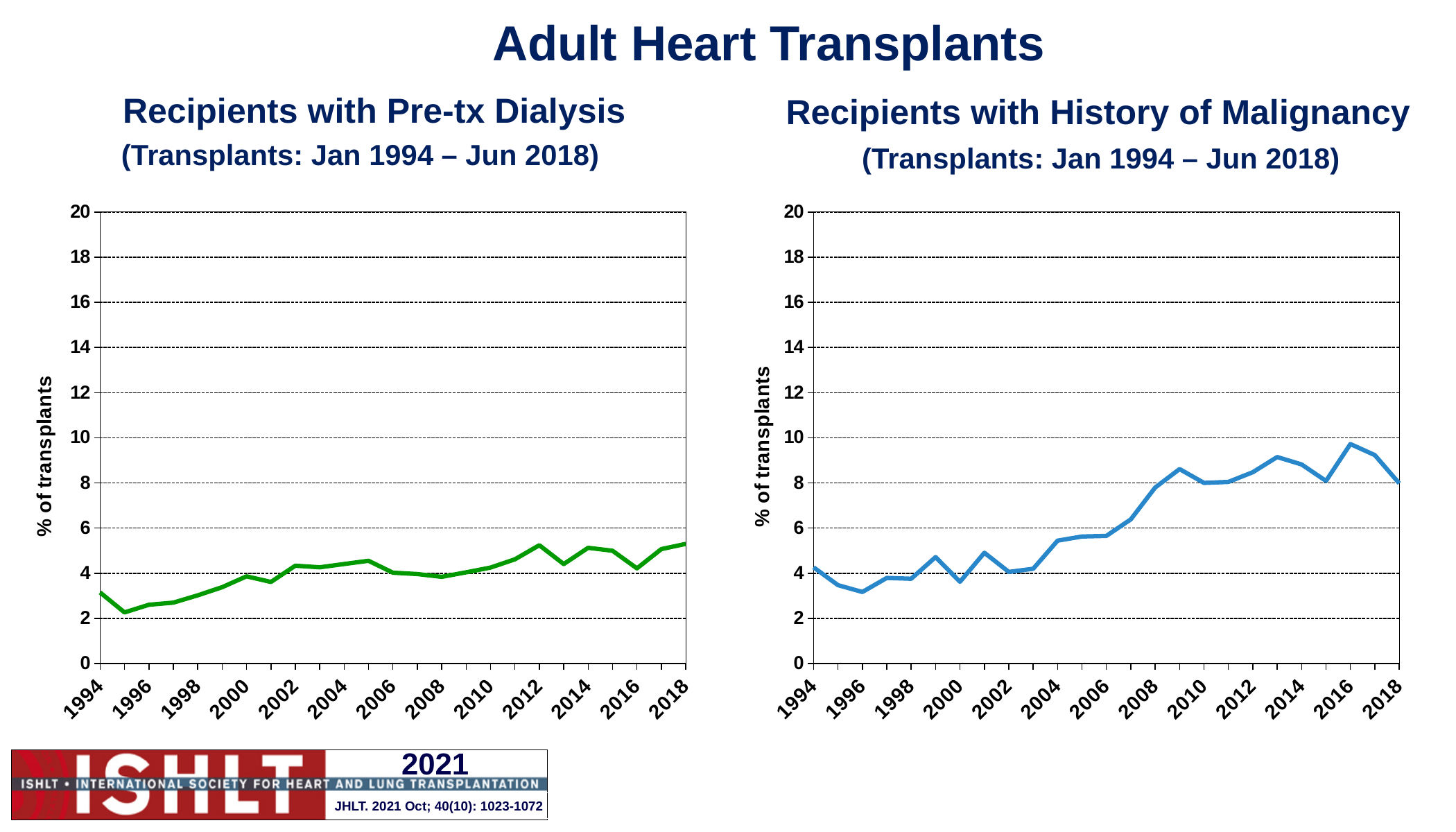
In the 'Recipients with History of Malignancy' chart, is the value for 2010 larger or smaller than the value for 2000? larger In the 'Recipients with Pre-tx Dialysis' chart, is the value for 2012 greater or less than 4? greater In the 'Recipients with History of Malignancy' chart, do the values generally rise or fall from 1994 to 2018? rise In the 'Recipients with History of Malignancy' chart, is the value for 2016 greater or less than 8? greater In the 'Recipients with Pre-tx Dialysis' chart, which year has the lowest value? 1995 In the 'Recipients with History of Malignancy' chart, is the value for 1996 greater or less than 4? less What kind of chart is the 'Recipients with History of Malignancy' chart? line chart In the 'Recipients with History of Malignancy' chart, which year has the highest value? 2016 In the 'Recipients with History of Malignancy' chart, which year has the lowest value? 1996 What is the y-axis label on the 'Recipients with Pre-tx Dialysis' chart? % of transplants What kind of chart is the 'Recipients with Pre-tx Dialysis' chart? line chart